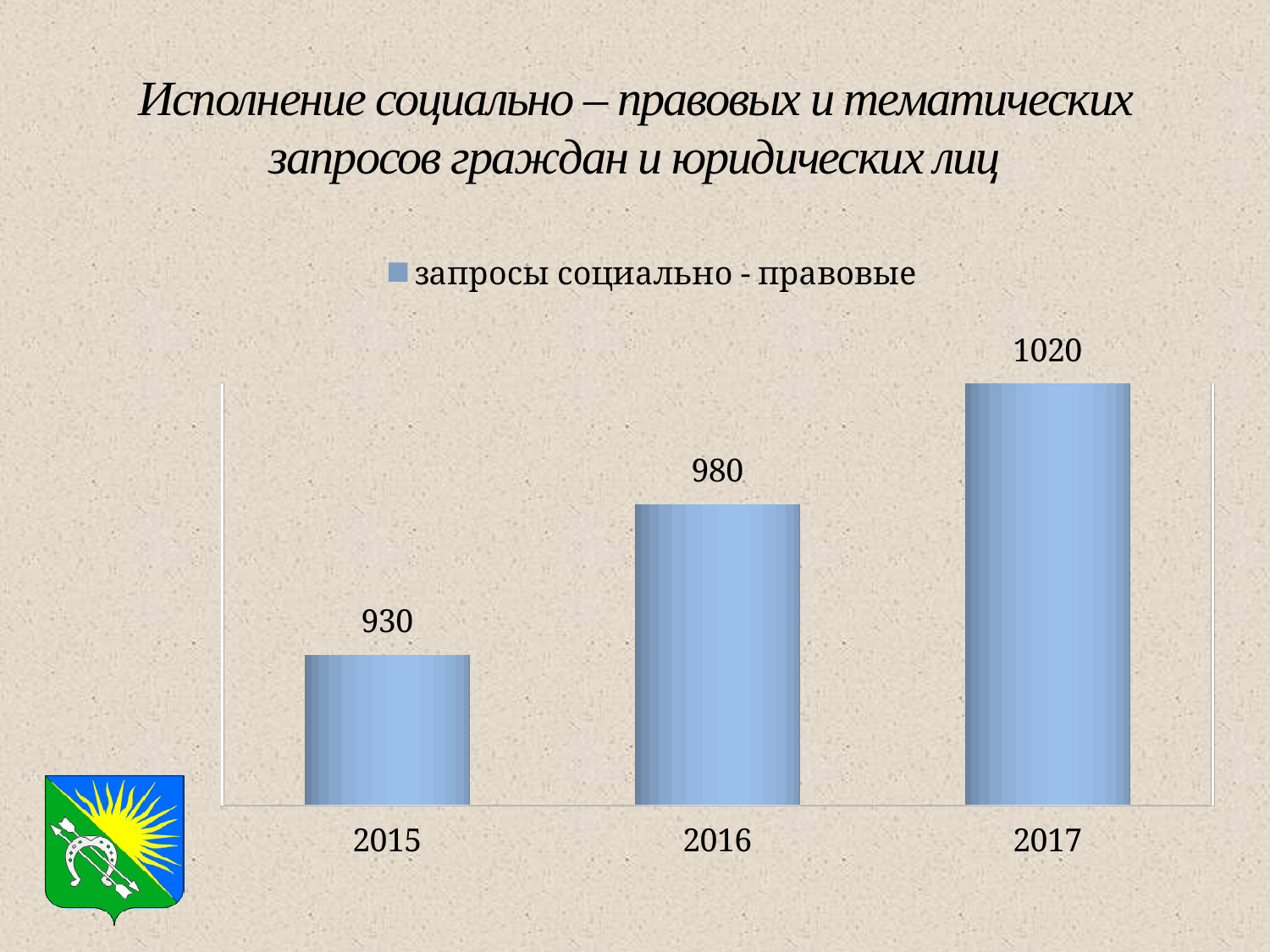
How many series does the legend list? 1 Do the values rise or fall from 2015 to 2017? rise What is the value for 2016? 980 What is the difference between the values for 2016 and 2015? 50 Which is larger, the value for 2016 or the value for 2017? 2017 Which year has the highest value? 2017 Which year has the lowest value? 2015 What is the value for 2017? 1020 What kind of chart is shown? bar chart How many years are shown on the x axis? 3 What is the value for 2015? 930 What is the difference between the values for 2017 and 2015? 90